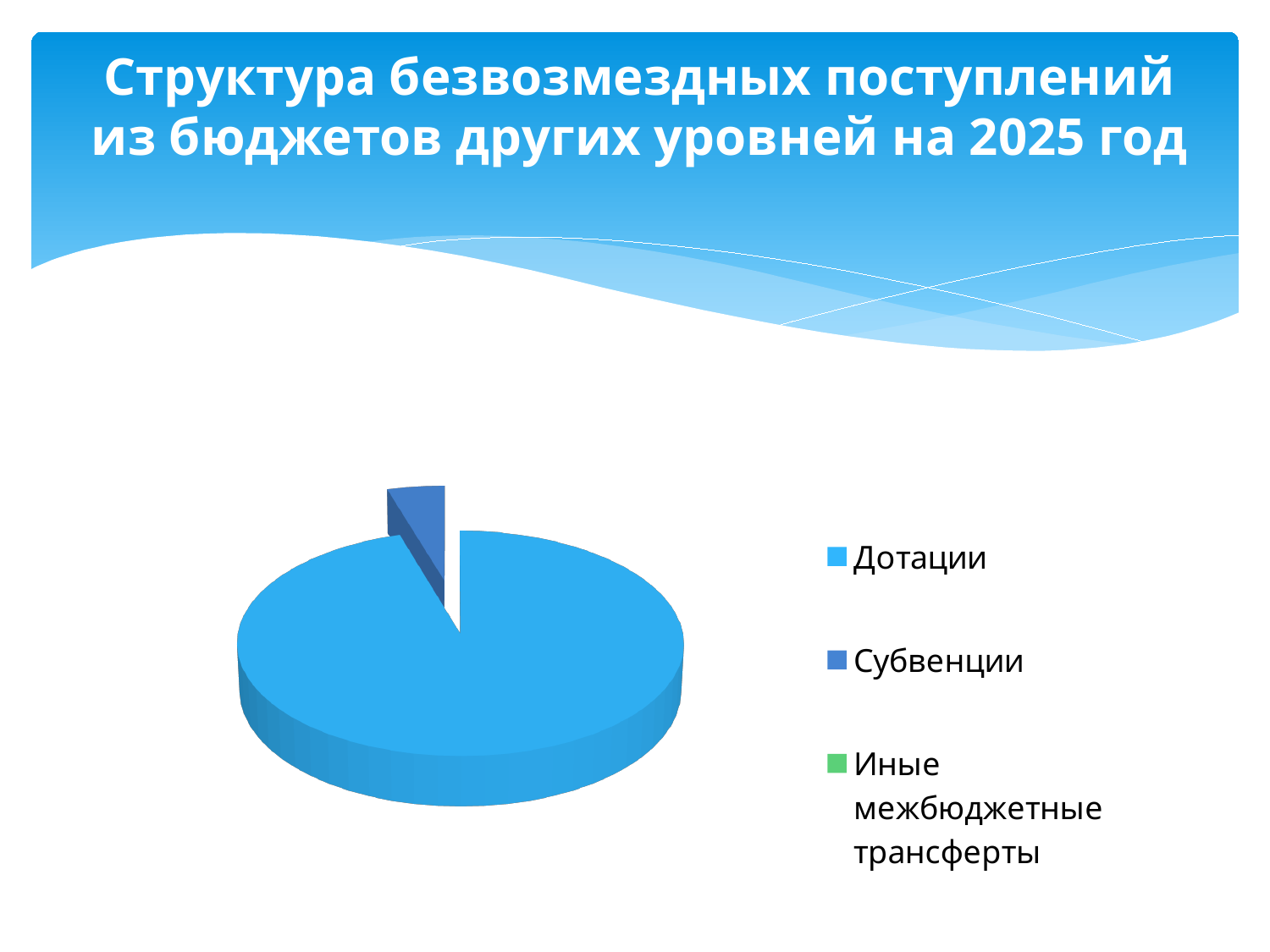
Which category is represented by the small dark blue slice? Субвенции What kind of chart is shown on the slide? Pie chart What is the title of the chart on the slide? Структура безвозмездных поступлений из бюджетов других уровней на 2025 год Which category has the largest slice of the pie? Дотации Which is larger, the slice for Дотации or the slice for Субвенции? Дотации How many entries does the chart legend list? 3 Which legend entry is shown in green? Иные межбюджетные трансферты